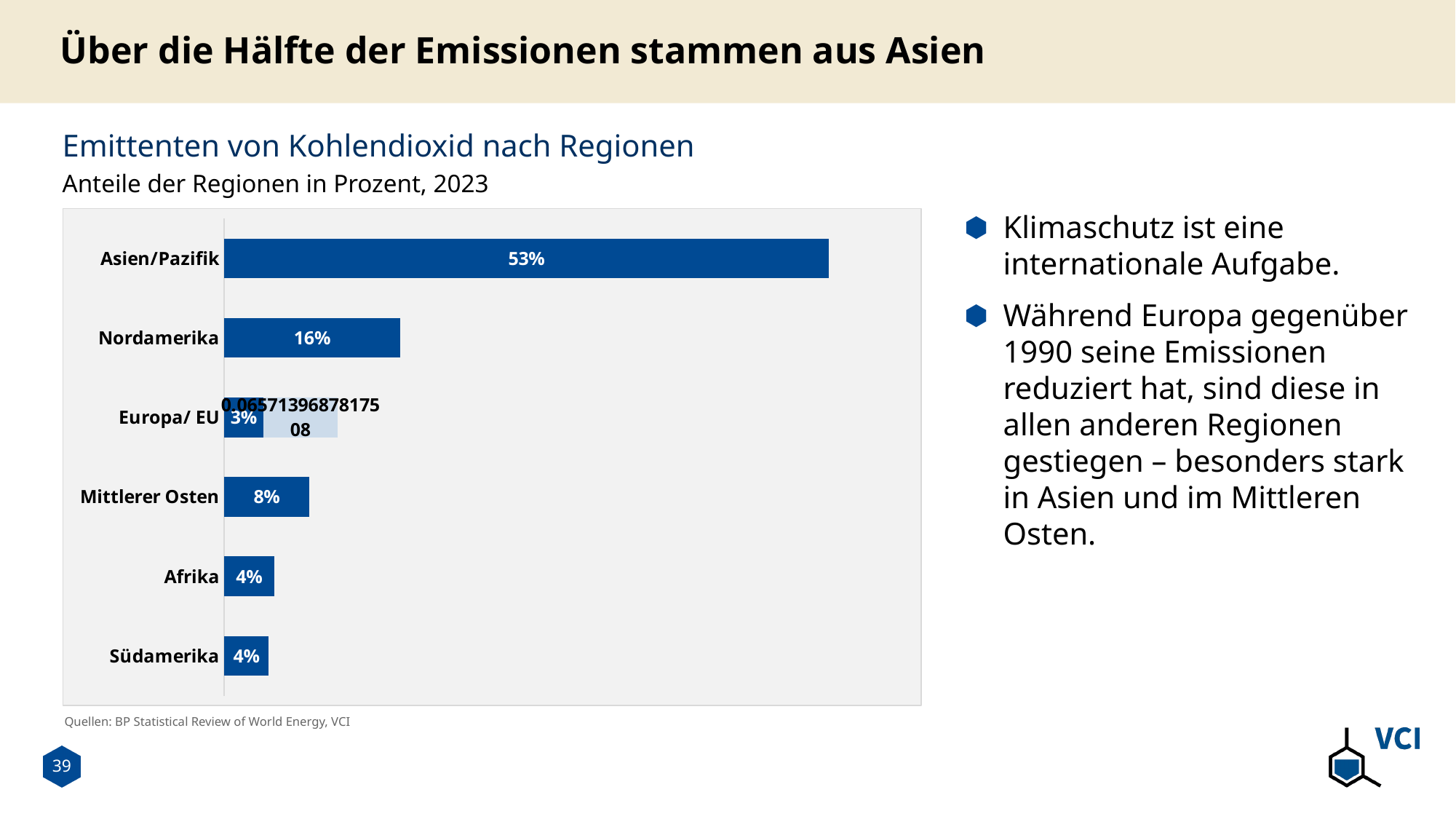
What is the value for Südamerika? 4% What is the value for Afrika? 4% What is the value for Asien/Pazifik? 53% What kind of chart is shown on the slide? Bar chart Which year does the chart's data refer to? 2023 What is the title of the chart? Emittenten von Kohlendioxid nach Regionen What is the difference between the values for Asien/Pazifik and Nordamerika? 37 percentage points What is the value for Mittlerer Osten? 8% What is the value for Nordamerika? 16% Which is larger, the value for Nordamerika or the value for Mittlerer Osten? Nordamerika Which region has the highest share? Asien/Pazifik How many regions are shown in the chart? 6